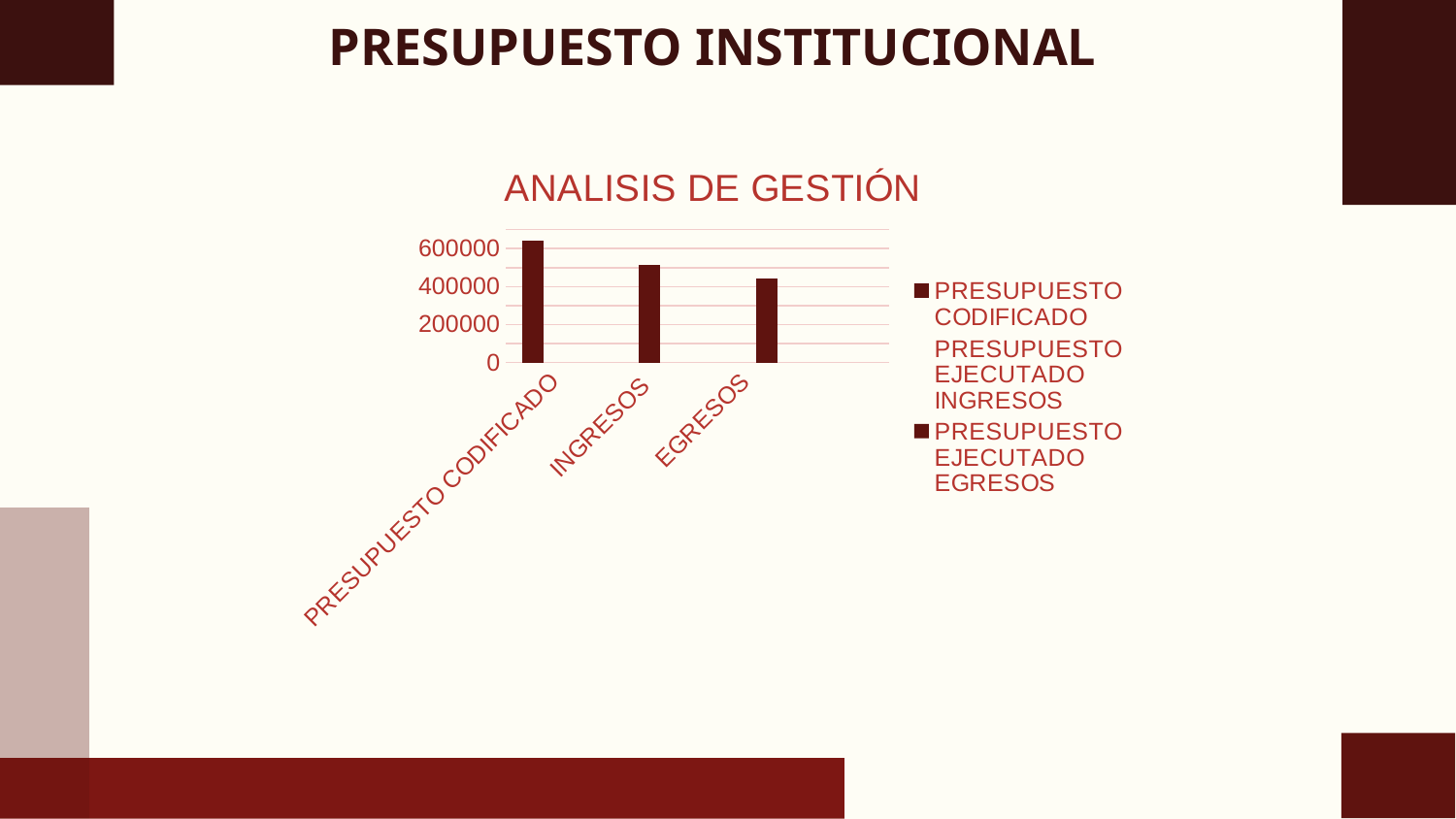
How many bars are plotted in the chart? 3 Is the value for INGRESOS greater or less than 400000? greater What type of chart is shown on the slide? bar chart What is the highest value labelled on the vertical axis? 600000 Is the value for PRESUPUESTO CODIFICADO greater or less than 400000? greater Which category has the highest bar? PRESUPUESTO CODIFICADO Which category has the lowest bar? EGRESOS Is the value for EGRESOS greater or less than 600000? less Which is larger, the bar for INGRESOS or the bar for EGRESOS? INGRESOS How many entries does the chart legend list? 3 What is the title of the chart? ANALISIS DE GESTIÓN Do the bar values rise or fall from left to right across the categories? fall